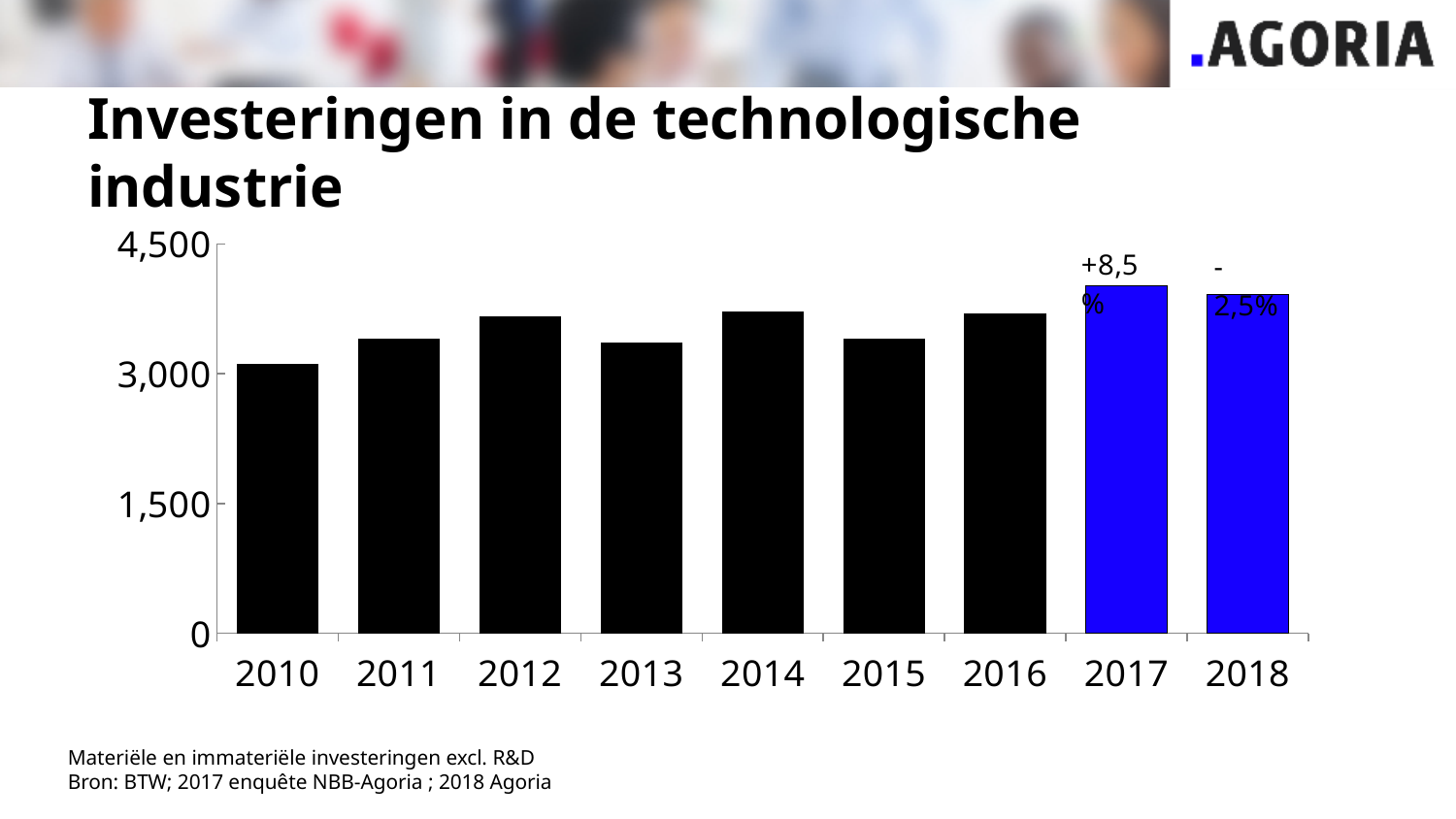
What kind of chart is shown on the slide? bar chart Is the value for 2017 greater or less than 4,500? less Which year has the lowest bar in the chart? 2010 What colour are the bars for 2017 and 2018? blue Is the value for 2013 greater or less than 1,500? greater Which year has the larger value, 2012 or 2013? 2012 How many years are shown on the x axis of the chart? 9 Is the value for 2016 greater or less than 3,000? greater Which year has the highest bar in the chart? 2017 Which year has the larger value, 2016 or 2017? 2017 What percentage change is annotated above the 2017 bar? +8,5% Which year has the larger value, 2014 or 2015? 2014